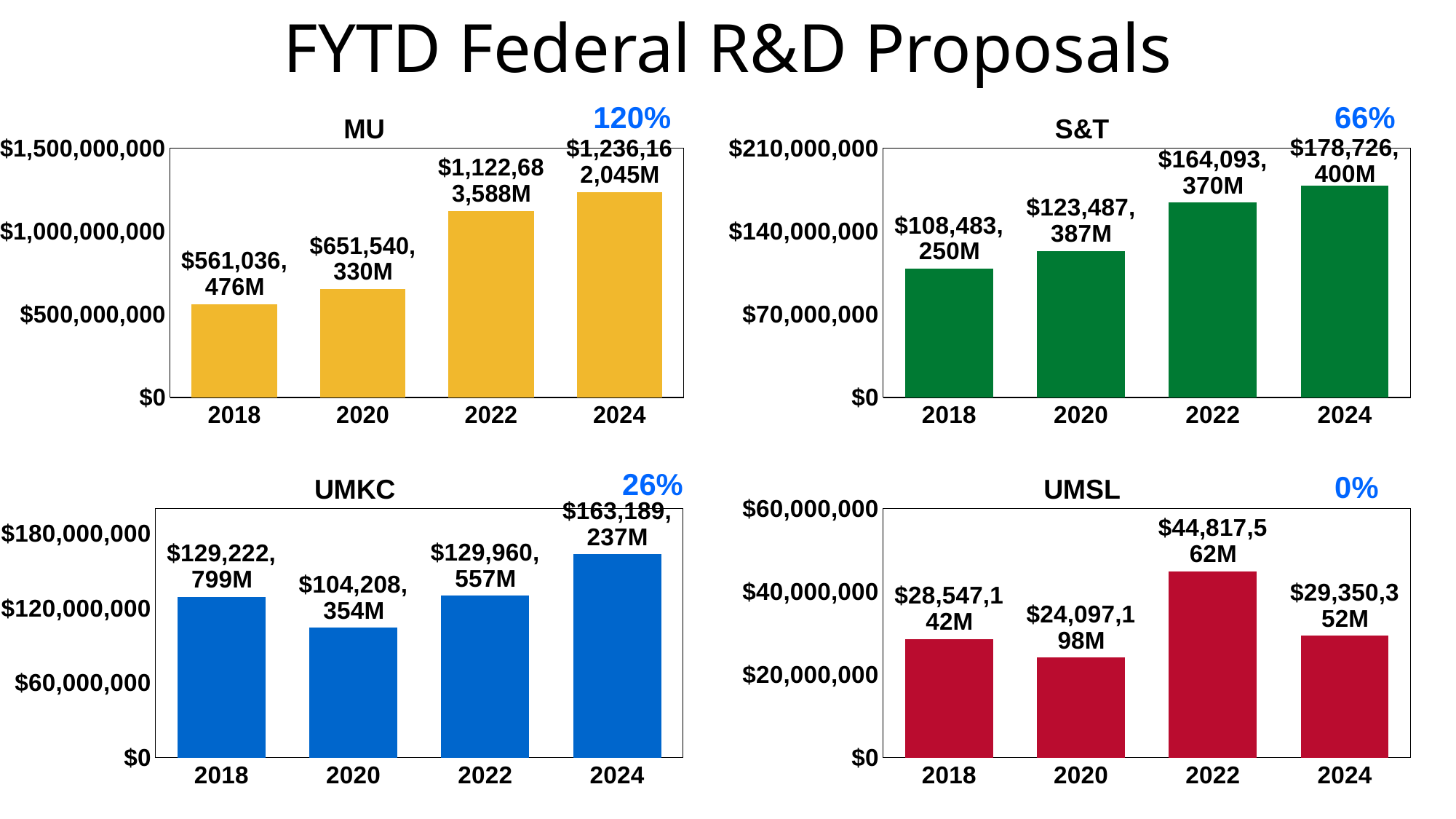
In the S&T chart, what is the value for 2024? $178,726,400M How many years are shown in the MU chart? 4 In the MU chart, is the value for 2022 greater or less than $1,000,000,000? greater In the S&T chart, is the value for 2022 larger than the value for 2020? Yes In the MU chart, what is the value for 2018? $561,036,476M In the UMSL chart, what is the value for 2022? $44,817,562M In the UMSL chart, is the value for 2020 greater or less than $40,000,000? less In the UMKC chart, what is the value for 2020? $104,208,354M In the UMSL chart, which year has the highest value? 2022 In the UMKC chart, which year has the lowest value? 2020 What kind of chart is the S&T chart? bar chart In the MU chart, do the values rise or fall from 2018 to 2024? rise